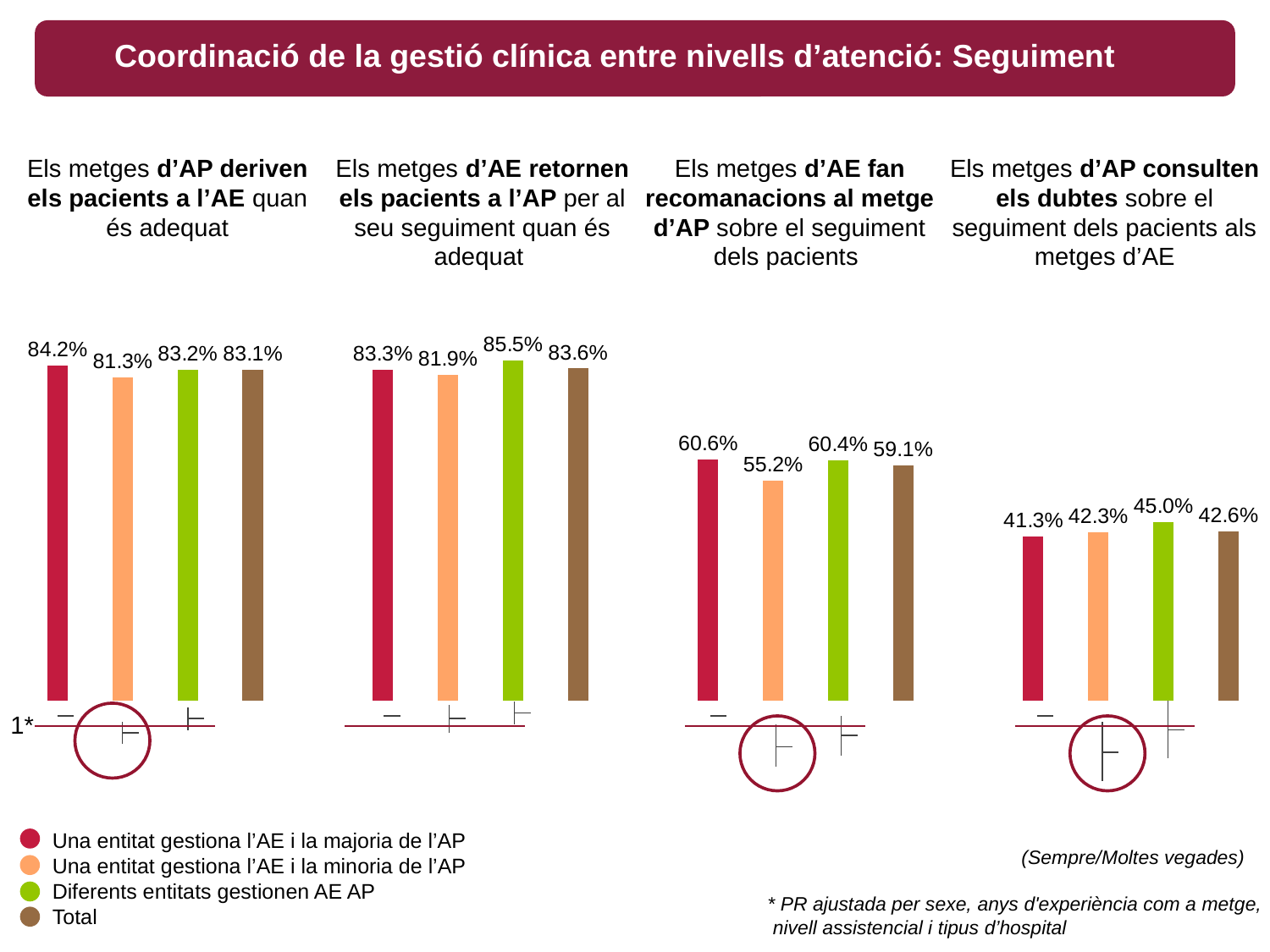
In the chart 'Els metges d'AP consulten els dubtes sobre el seguiment dels pacients als metges d'AE', which category has the highest value? Diferents entitats gestionen AE AP In the chart 'Els metges d'AP deriven els pacients a l'AE quan és adequat', what is the value for 'Una entitat gestiona l'AE i la majoria de l'AP'? 84.2% In the chart 'Els metges d'AE retornen els pacients a l'AP per al seu seguiment quan és adequat', what is the difference between 'Diferents entitats gestionen AE AP' and 'Una entitat gestiona l'AE i la minoria de l'AP'? 3.6% In the chart 'Els metges d'AE retornen els pacients a l'AP per al seu seguiment quan és adequat', what is the value for 'Diferents entitats gestionen AE AP'? 85.5% Which legend entry is shown in brown? Total In the chart 'Els metges d'AE fan recomanacions al metge d'AP sobre el seguiment dels pacients', which category has the lowest value? Una entitat gestiona l'AE i la minoria de l'AP In the chart 'Els metges d'AP consulten els dubtes sobre el seguiment dels pacients als metges d'AE', what is the value for 'Una entitat gestiona l'AE i la minoria de l'AP'? 42.3% How many bars are shown in the chart 'Els metges d'AE fan recomanacions al metge d'AP sobre el seguiment dels pacients'? 4 In the chart 'Els metges d'AP deriven els pacients a l'AE quan és adequat', which is larger: 'Una entitat gestiona l'AE i la majoria de l'AP' or 'Una entitat gestiona l'AE i la minoria de l'AP'? Una entitat gestiona l'AE i la majoria de l'AP What kind of chart is used for 'Els metges d'AP consulten els dubtes sobre el seguiment dels pacients als metges d'AE'? Bar chart In the chart 'Els metges d'AE fan recomanacions al metge d'AP sobre el seguiment dels pacients', what is the value for 'Total'? 59.1% How many series does the legend list? 4